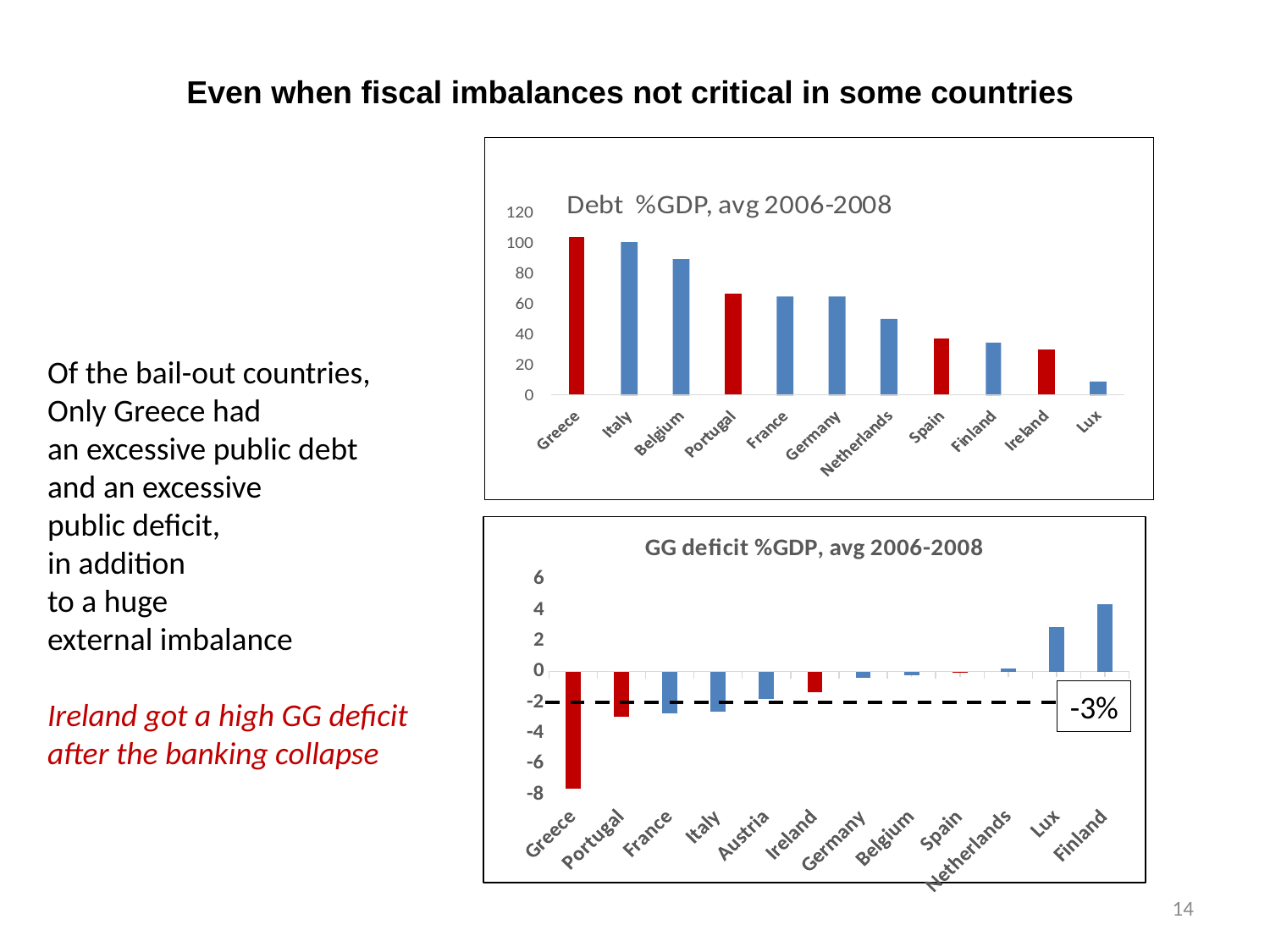
In the 'GG deficit %GDP, avg 2006-2008' chart, what value is the dashed horizontal line labelled with? -3% In the 'Debt %GDP, avg 2006-2008' chart, is the value for Belgium greater or less than 80? greater In the 'GG deficit %GDP, avg 2006-2008' chart, which country has the lowest (most negative) value? Greece In the 'Debt %GDP, avg 2006-2008' chart, how many countries are shown? 11 In the 'Debt %GDP, avg 2006-2008' chart, which country has the lowest debt? Lux In the 'GG deficit %GDP, avg 2006-2008' chart, is the value for Greece greater or less than -6? less What kind of chart is the 'Debt %GDP, avg 2006-2008' chart? bar chart In the 'GG deficit %GDP, avg 2006-2008' chart, which country has the highest value? Finland In the 'Debt %GDP, avg 2006-2008' chart, which is larger, the value for Italy or the value for Belgium? Italy In the 'GG deficit %GDP, avg 2006-2008' chart, how many countries are shown? 12 In the 'Debt %GDP, avg 2006-2008' chart, do the values rise or fall from left to right? fall In the 'Debt %GDP, avg 2006-2008' chart, is the value for Spain greater or less than 40? less